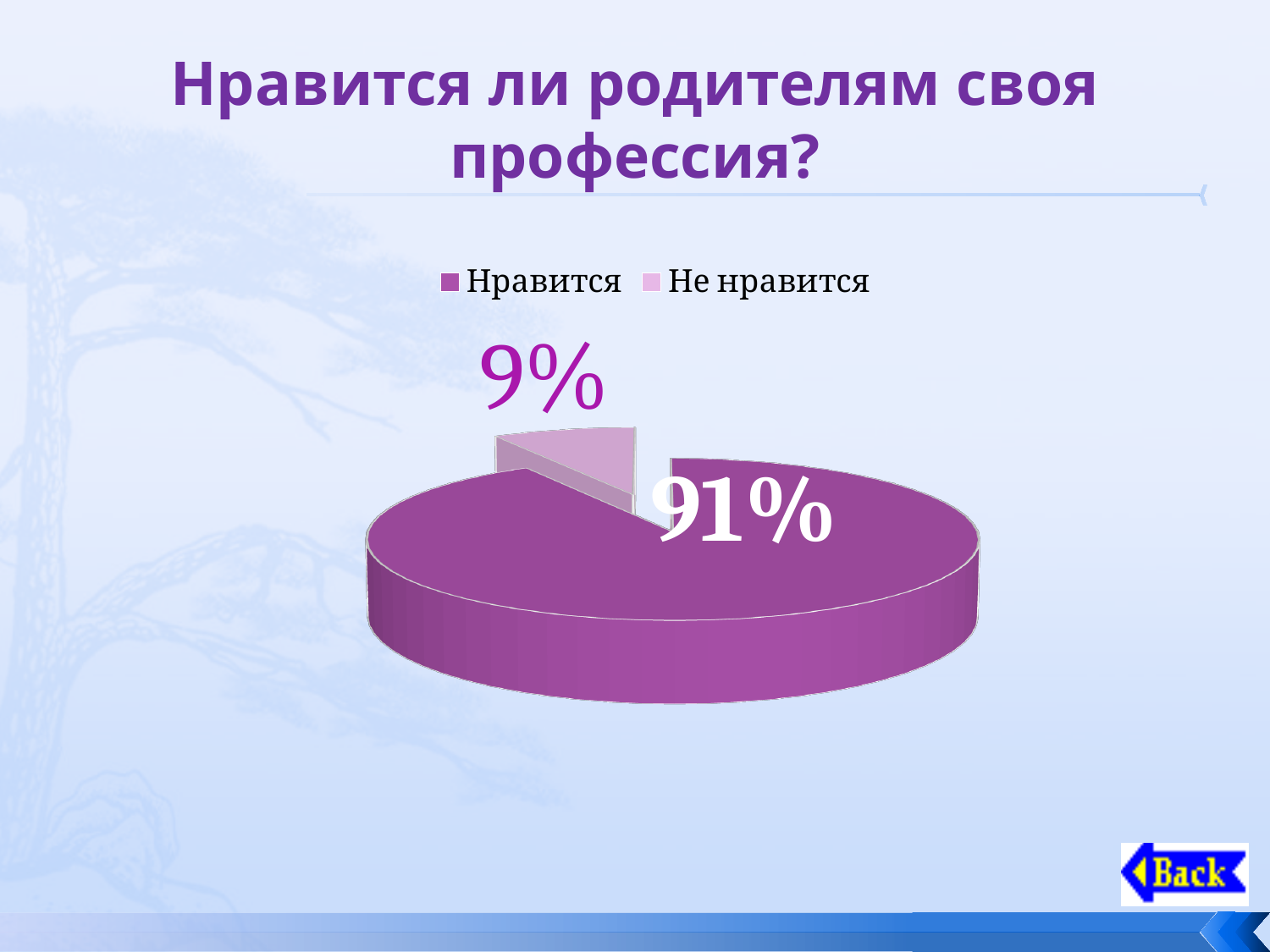
How many entries does the legend list? 2 What share of the pie does "Нравится" take? 91% Which slice of the pie is the largest? Нравится What is the difference in percentage points between the "Нравится" and "Не нравится" slices? 82 Which is larger, the "Нравится" slice or the "Не нравится" slice? Нравится Which slice of the pie is the smallest? Не нравится What is the title of the slide containing the chart? Нравится ли родителям своя профессия? How many slices does the pie chart have? 2 What kind of chart is shown on the slide? pie chart Which legend entry is shown in the lighter pink colour? Не нравится What share of the pie does "Не нравится" take? 9%